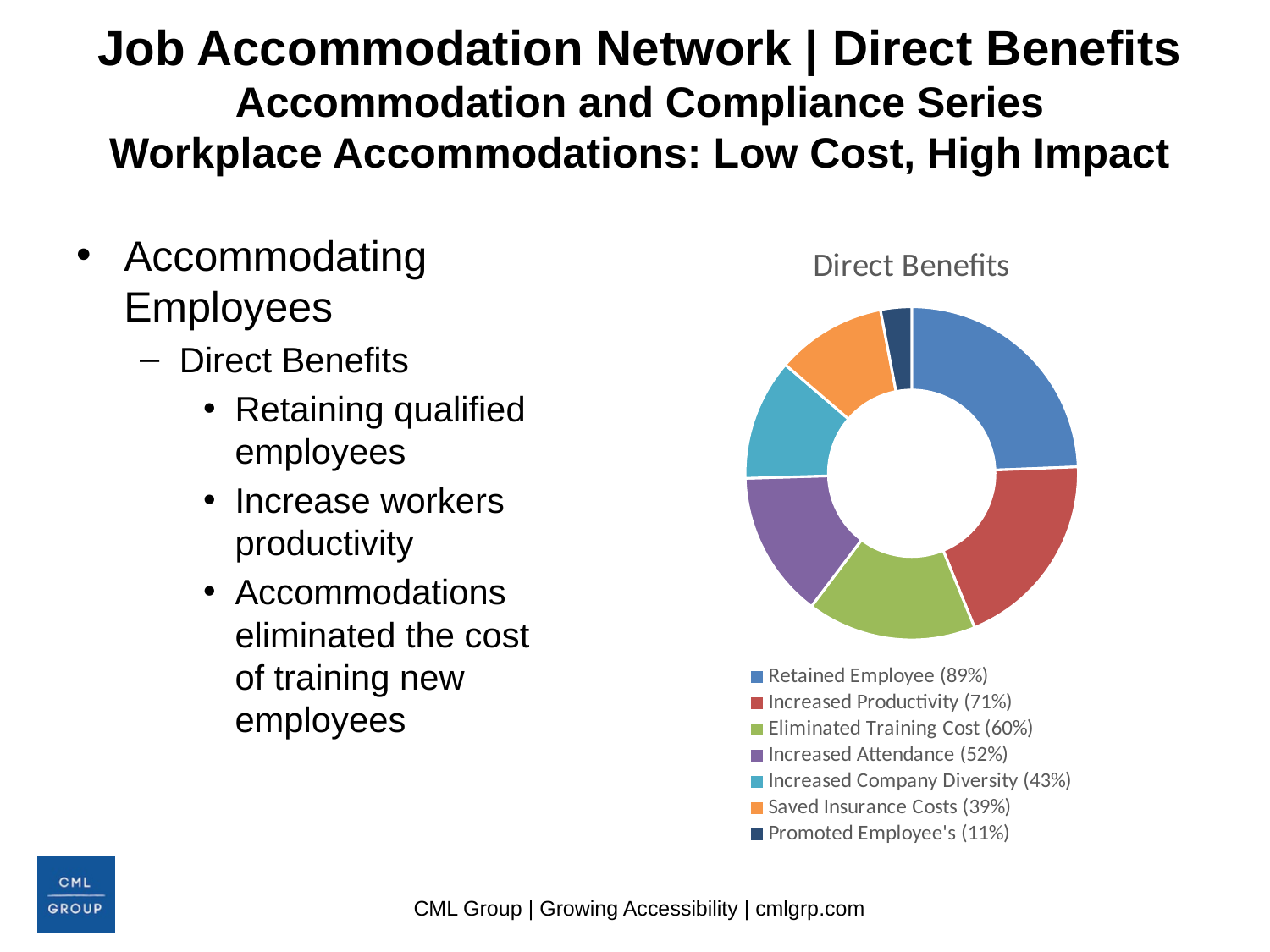
Which category has the lowest percentage in the chart? Promoted Employee's What percentage is shown for Retained Employee in the chart legend? 89% Which is larger, Increased Company Diversity or Saved Insurance Costs? Increased Company Diversity What kind of chart is shown on the slide? doughnut chart What is the title of the chart? Direct Benefits Which category has the highest percentage in the chart? Retained Employee What is the difference in percentage points between Increased Productivity and Eliminated Training Cost? 11 What percentage is shown for Saved Insurance Costs? 39% What percentage is shown for Promoted Employee's? 11% What percentage is shown for Increased Attendance? 52% What colour is the Eliminated Training Cost segment? green How many categories does the chart legend list? 7